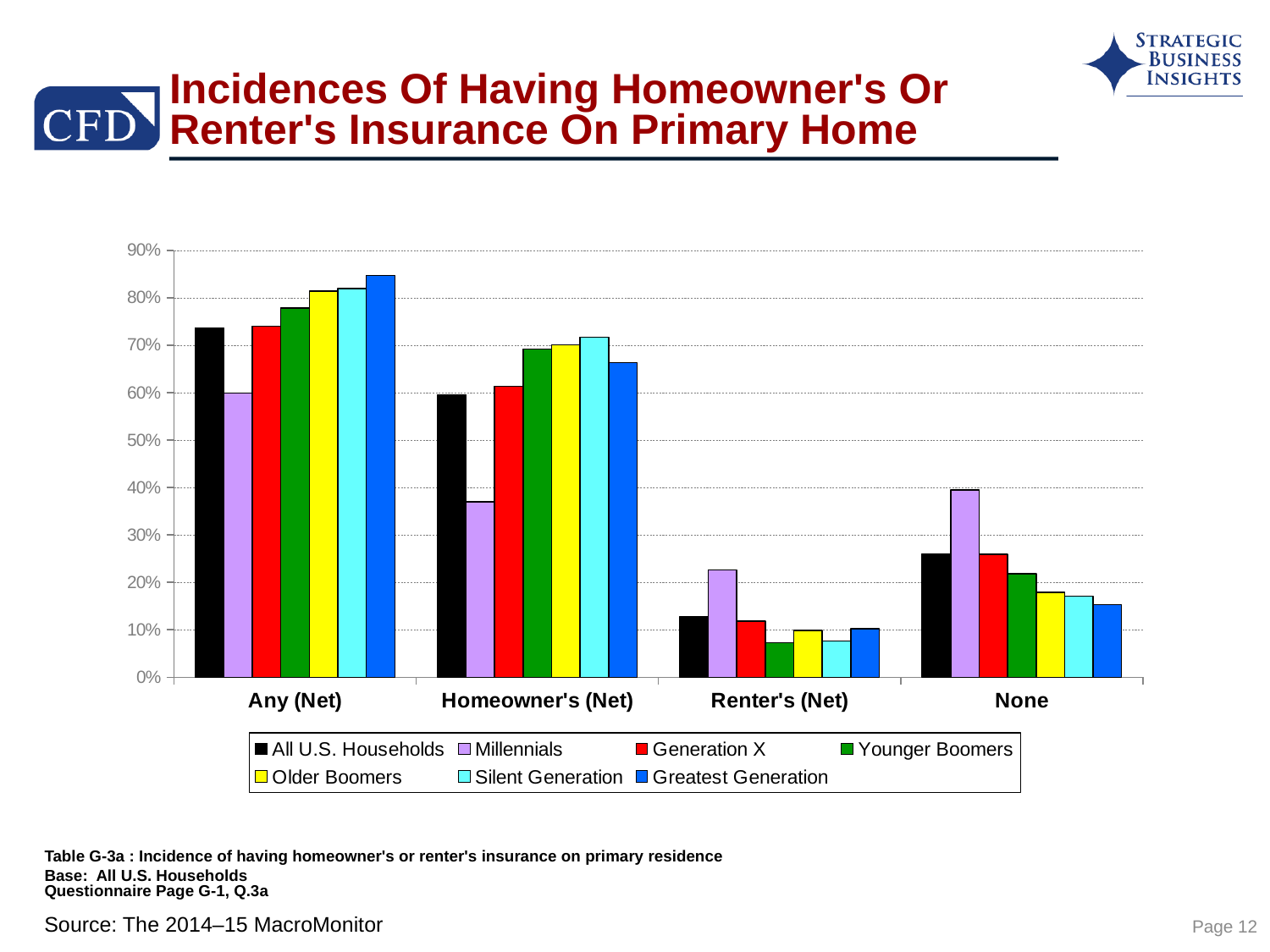
Which series has the highest value in the Renter's (Net) category? Millennials In the Renter's (Net) category, which is larger: Millennials or Younger Boomers? Millennials Which series has the highest value in the Any (Net) category? Greatest Generation What colour represents Generation X in the legend? red Which series has the highest value in the None category? Millennials Which series has the lowest value in the Any (Net) category? Millennials How many series does the legend list? 7 How many categories are shown along the x axis? 4 Is the value for Millennials in the Homeowner's (Net) category greater or less than 40%? less Which series has the lowest value in the Homeowner's (Net) category? Millennials Is the value for Greatest Generation in the Any (Net) category greater or less than 80%? greater What kind of chart is shown on the slide? bar chart